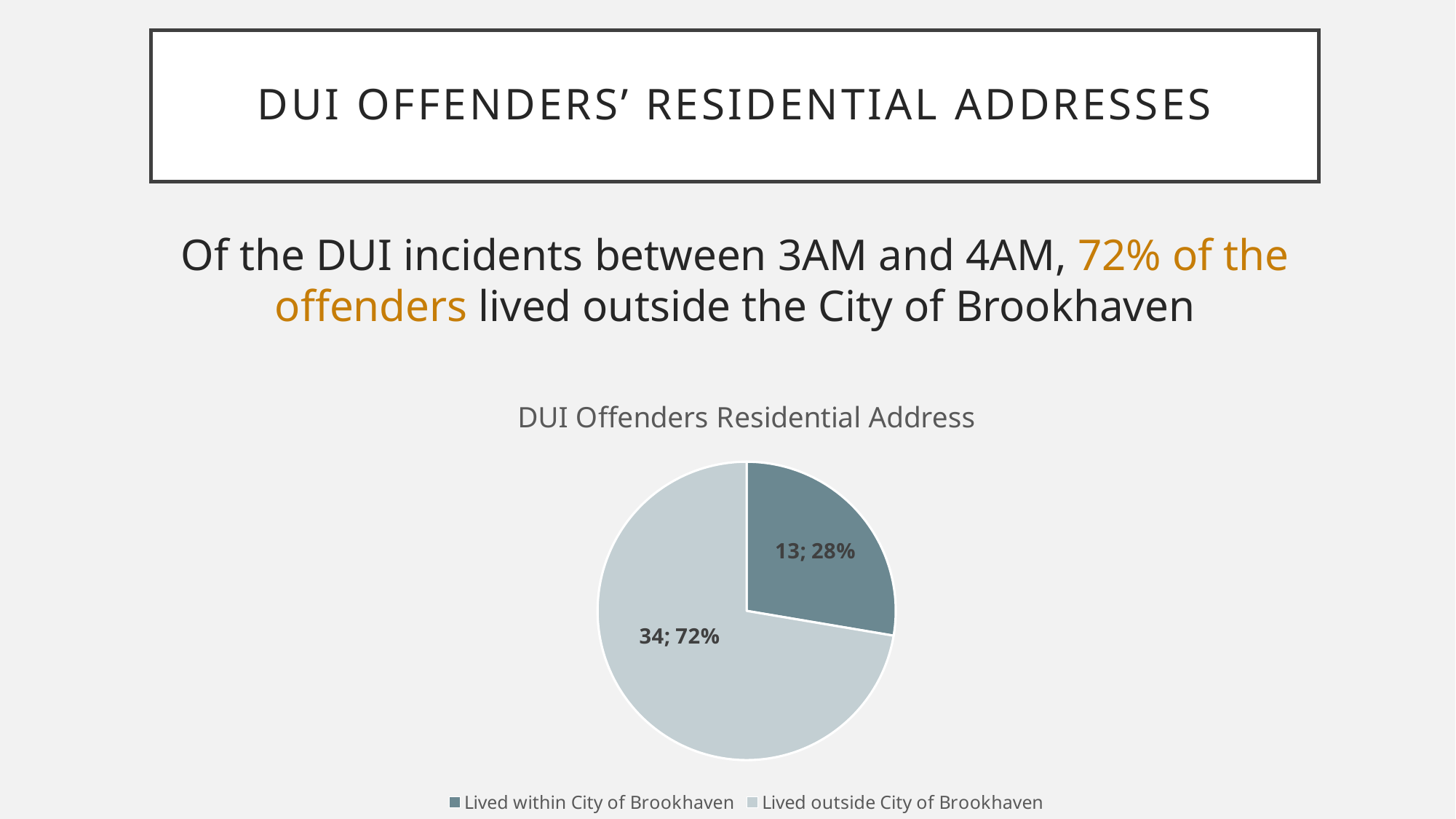
What is the title of the chart? DUI Offenders Residential Address Which category has the largest slice? Lived outside City of Brookhaven What is the total number of DUI offenders represented in the pie chart? 47 What share of the pie is 'Lived within City of Brookhaven'? 28% How many slices does the pie chart have? 2 What is the difference in count between offenders who lived outside and those who lived within the City of Brookhaven? 21 How many entries does the legend list? 2 What share of the pie is 'Lived outside City of Brookhaven'? 72% Which category has the smallest slice? Lived within City of Brookhaven What type of chart is shown on the slide? pie chart How many DUI offenders lived within the City of Brookhaven? 13 How many DUI offenders lived outside the City of Brookhaven? 34